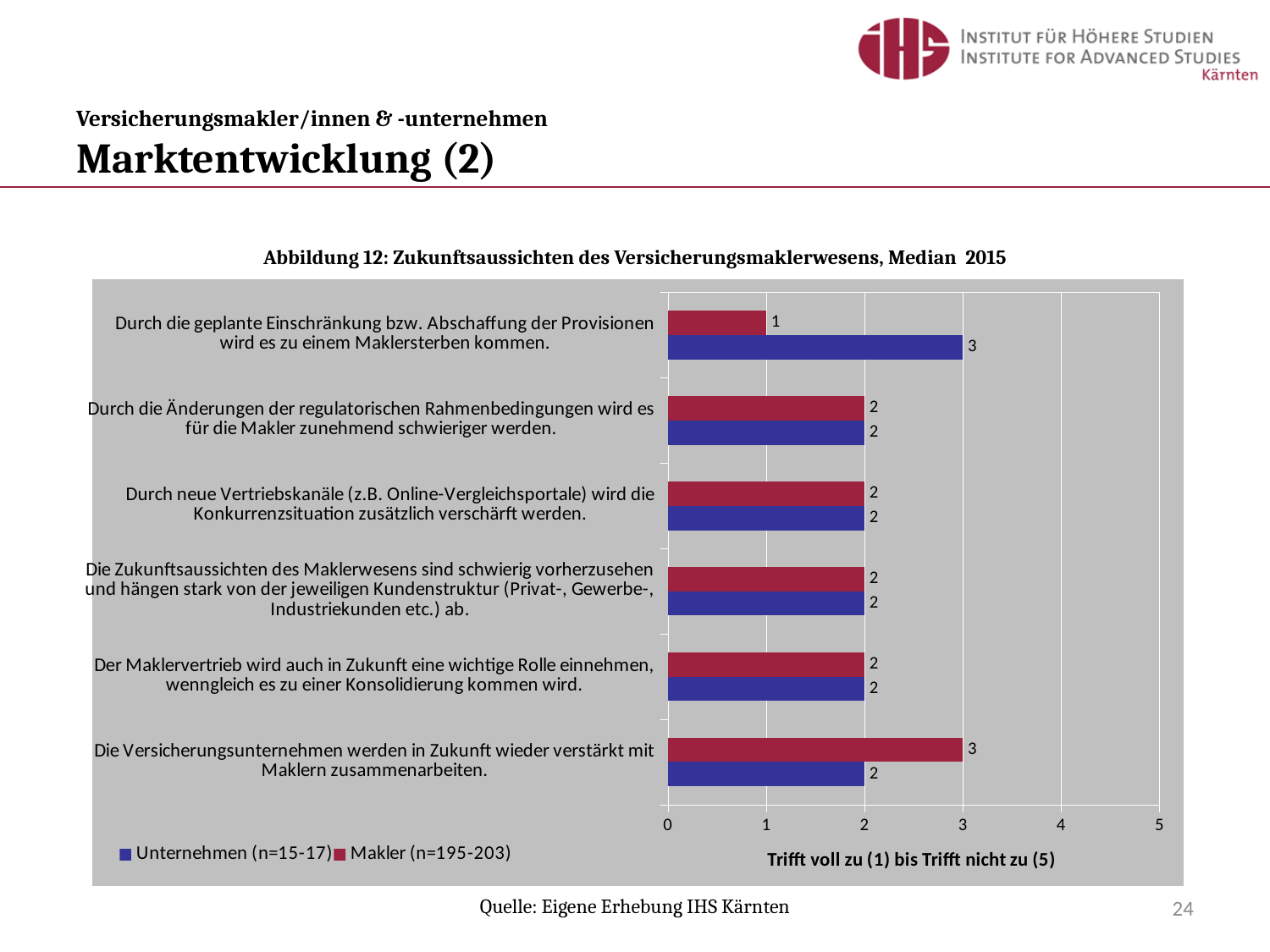
What type of chart is shown on the slide? bar chart For the statement 'Die Versicherungsunternehmen werden in Zukunft wieder verstärkt mit Maklern zusammenarbeiten.', which series has the larger value, Unternehmen (n=15-17) or Makler (n=195-203)? Makler (n=195-203) For which statement is the Makler (n=195-203) value the highest? Die Versicherungsunternehmen werden in Zukunft wieder verstärkt mit Maklern zusammenarbeiten. What is the Unternehmen (n=15-17) value for the statement 'Der Maklervertrieb wird auch in Zukunft eine wichtige Rolle einnehmen, wenngleich es zu einer Konsolidierung kommen wird.'? 2 What is the title of the chart? Abbildung 12: Zukunftsaussichten des Versicherungsmaklerwesens, Median 2015 What is the Makler (n=195-203) value for the statement 'Die Versicherungsunternehmen werden in Zukunft wieder verstärkt mit Maklern zusammenarbeiten.'? 3 How many statements (categories) are plotted in the chart? 6 What is the difference between the Unternehmen (n=15-17) and Makler (n=195-203) values for the statement 'Durch die geplante Einschränkung bzw. Abschaffung der Provisionen wird es zu einem Maklersterben kommen.'? 2 For which statement is the Makler (n=195-203) value the lowest? Durch die geplante Einschränkung bzw. Abschaffung der Provisionen wird es zu einem Maklersterben kommen. What is the Makler (n=195-203) value for the statement 'Durch die geplante Einschränkung bzw. Abschaffung der Provisionen wird es zu einem Maklersterben kommen.'? 1 What is the Unternehmen (n=15-17) value for the statement 'Durch die geplante Einschränkung bzw. Abschaffung der Provisionen wird es zu einem Maklersterben kommen.'? 3 How many series does the legend list? 2